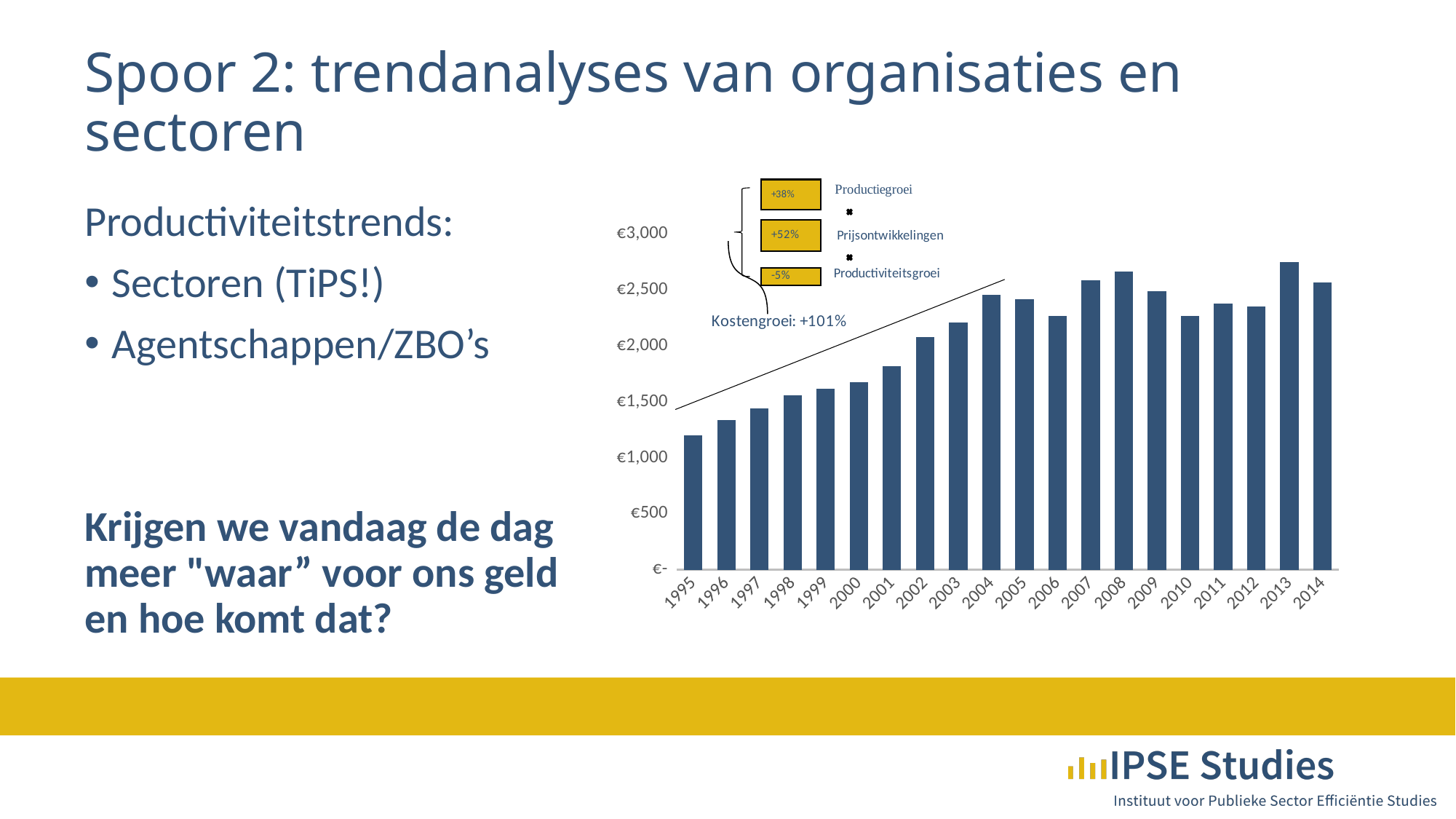
Is the value for 2013 greater or less than €2,500? greater Which year has the highest bar in the chart? 2013 How many years are shown on the x axis of the chart? 20 Is the value for 1995 greater or less than €1,500? less Is the value for 2010 greater or less than €2,500? less What percentage is shown in the box labelled Productiviteitsgroei on the chart? -5% Which year has the lowest bar in the chart? 1995 What kind of chart is shown on the slide? bar chart Do the values generally rise or fall from 1995 to 2004? rise Which year has the larger value, 2013 or 2014? 2013 What cost growth (Kostengroei) percentage is annotated on the chart? +101%